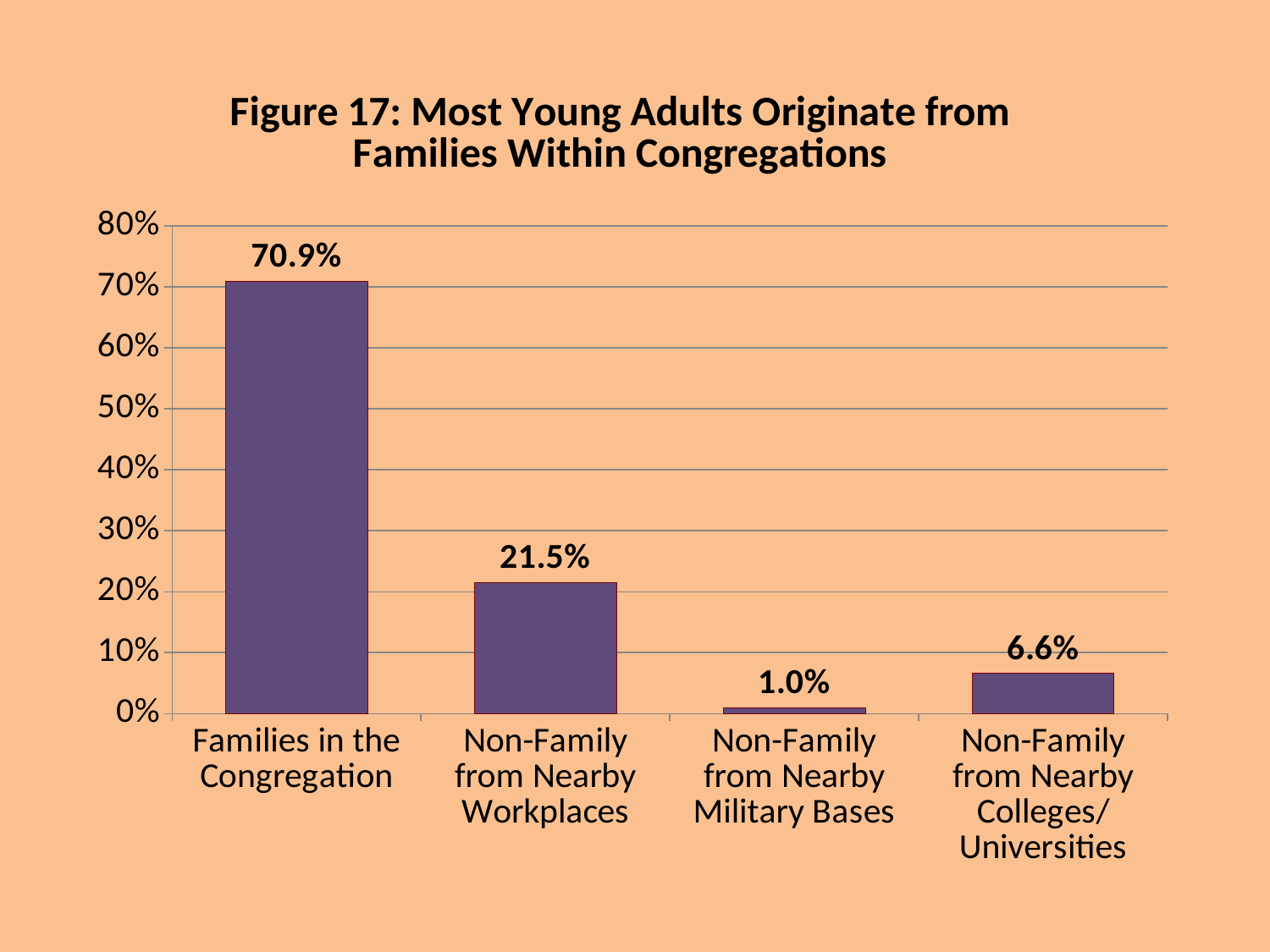
Which category has the lowest value? Non-Family from Nearby Military Bases What is the value for Families in the Congregation? 70.9% What is the difference between the values for Families in the Congregation and Non-Family from Nearby Workplaces? 49.4% Which category has the highest value? Families in the Congregation Which is larger, the value for Non-Family from Nearby Colleges/Universities or Non-Family from Nearby Military Bases? Non-Family from Nearby Colleges/Universities Is the value for Non-Family from Nearby Workplaces greater or less than 30%? less What is the title of the chart? Figure 17: Most Young Adults Originate from Families Within Congregations What is the value for Non-Family from Nearby Military Bases? 1.0% What is the value for Non-Family from Nearby Workplaces? 21.5% What kind of chart is shown on the slide? bar chart What is the value for Non-Family from Nearby Colleges/Universities? 6.6% How many categories are shown in the chart? 4